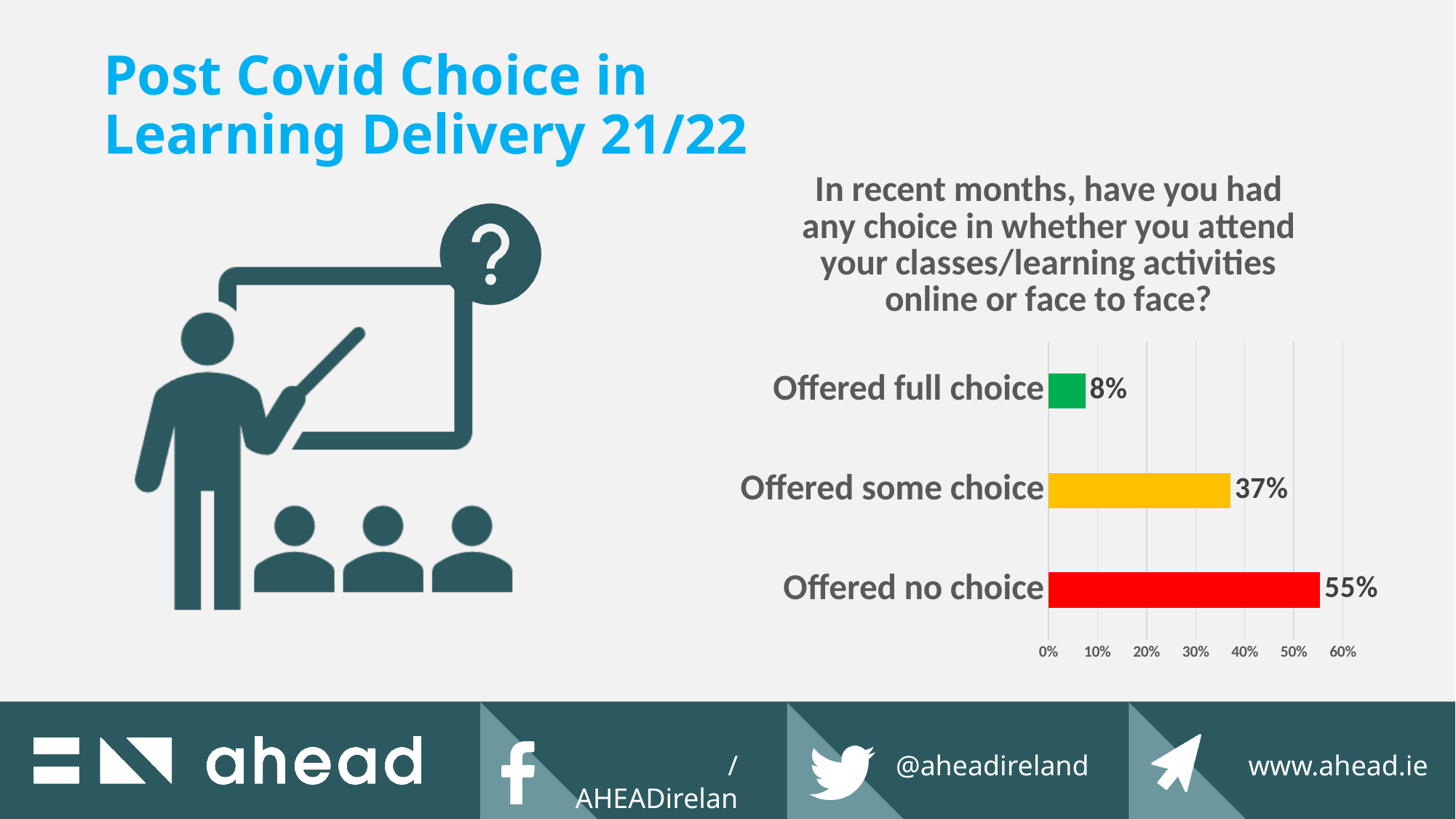
Which category has the lowest value? Offered full choice What percentage of respondents were offered no choice? 55% What percentage of respondents were offered full choice? 8% Which category has the highest value? Offered no choice What is the difference in percentage points between 'Offered no choice' and 'Offered some choice'? 18 Which is larger: the value for 'Offered some choice' or 'Offered full choice'? Offered some choice What percentage of respondents were offered some choice? 37% How many categories are shown in the chart? 3 What colour is the bar for 'Offered no choice'? Red Is the value for 'Offered no choice' greater or less than 50%? greater What kind of chart is shown on the slide? Bar chart What is the difference in percentage points between 'Offered some choice' and 'Offered full choice'? 29